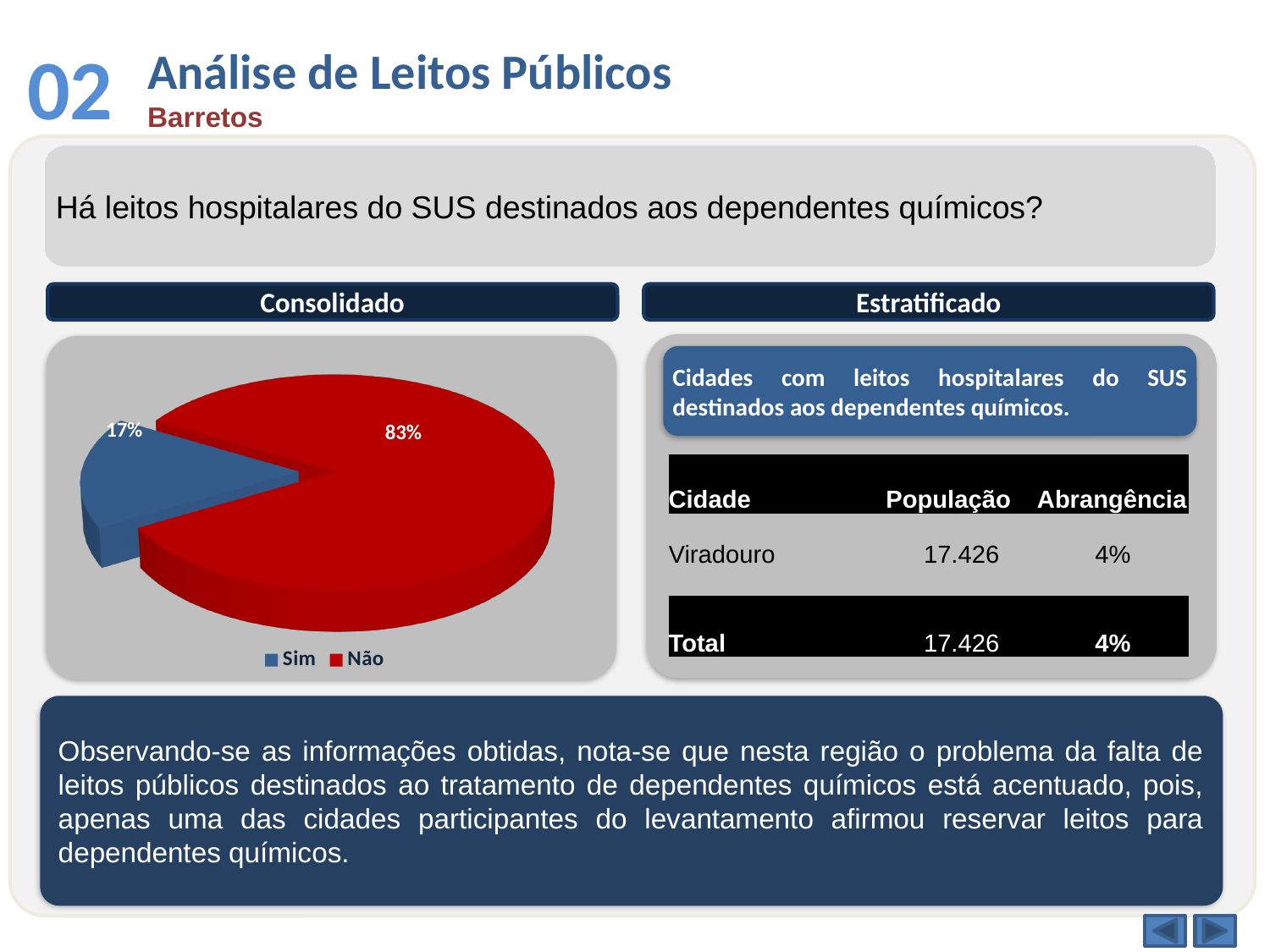
How many entries does the pie chart's legend list? 2 Which is larger in the pie chart, "Sim" or "Não"? Não What colour is the "Não" slice in the pie chart? Red What colour is the "Sim" slice in the pie chart? Blue What kind of chart is shown under the "Consolidado" heading? Pie chart What is the difference in percentage points between the "Não" and "Sim" slices of the pie chart? 66 Which slice of the pie chart is the smallest? Sim What share of the pie chart does the "Sim" slice represent? 17% How many slices does the pie chart have? 2 Which slice of the pie chart is the largest? Não In the pie chart, what percentage is shown for "Sim"? 17% In the pie chart, what percentage is shown for "Não"? 83%